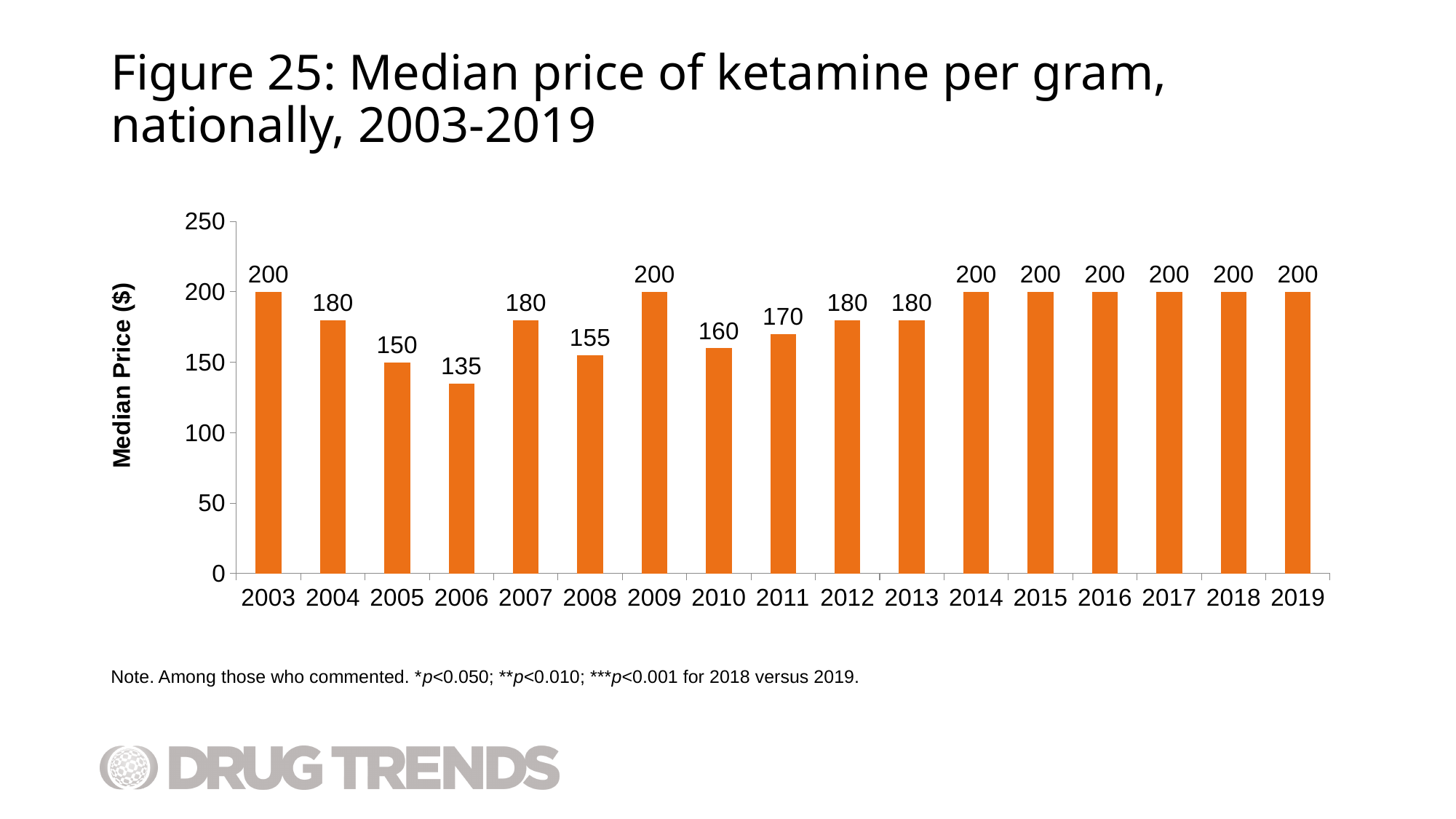
What is the difference between the median price in 2003 and the median price in 2006? 65 What is the median price of ketamine per gram in 2008? 155 What is the median price of ketamine per gram in 2006? 135 What is the difference between the median price in 2010 and the median price in 2012? 20 What is the median price of ketamine per gram in 2011? 170 Does the median price rise or fall from 2006 to 2009? Rise Which year has the lowest median price of ketamine per gram? 2006 How many years are shown on the x axis? 17 Which is larger, the median price in 2007 or the median price in 2008? 2007 Is the median price for 2005 greater or less than 100? greater What is the label of the y axis? Median Price ($) What kind of chart is shown on the slide? Bar chart